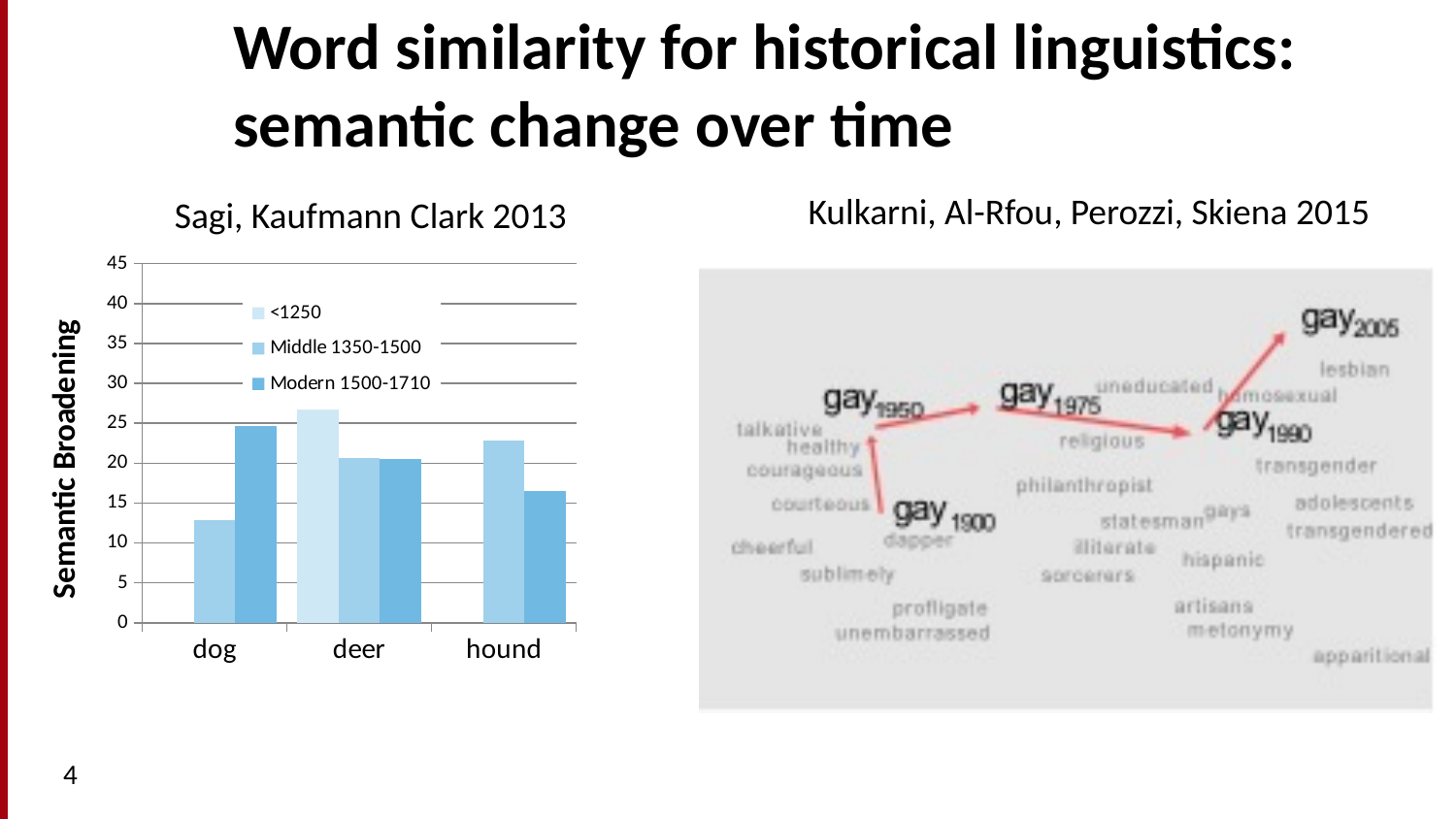
In the bar chart, which is larger for hound: the Middle 1350-1500 value or the Modern 1500-1710 value? Middle 1350-1500 Which series in the bar chart is shown in the lightest blue? <1250 How many categories are shown on the x axis of the bar chart? 3 How many series does the legend of the bar chart list? 3 What is the label of the vertical axis of the bar chart? Semantic Broadening What kind of chart is shown under the heading 'Sagi, Kaufmann Clark 2013'? bar chart In the bar chart, is the Modern 1500-1710 value for hound greater or less than 20? less In the bar chart, which is larger for dog: the Middle 1350-1500 value or the Modern 1500-1710 value? Modern 1500-1710 In the bar chart, is the Modern 1500-1710 value for dog greater or less than 20? greater In the bar chart, is the Middle 1350-1500 value for dog greater or less than 15? less In the bar chart, which category has the highest Modern 1500-1710 value? dog